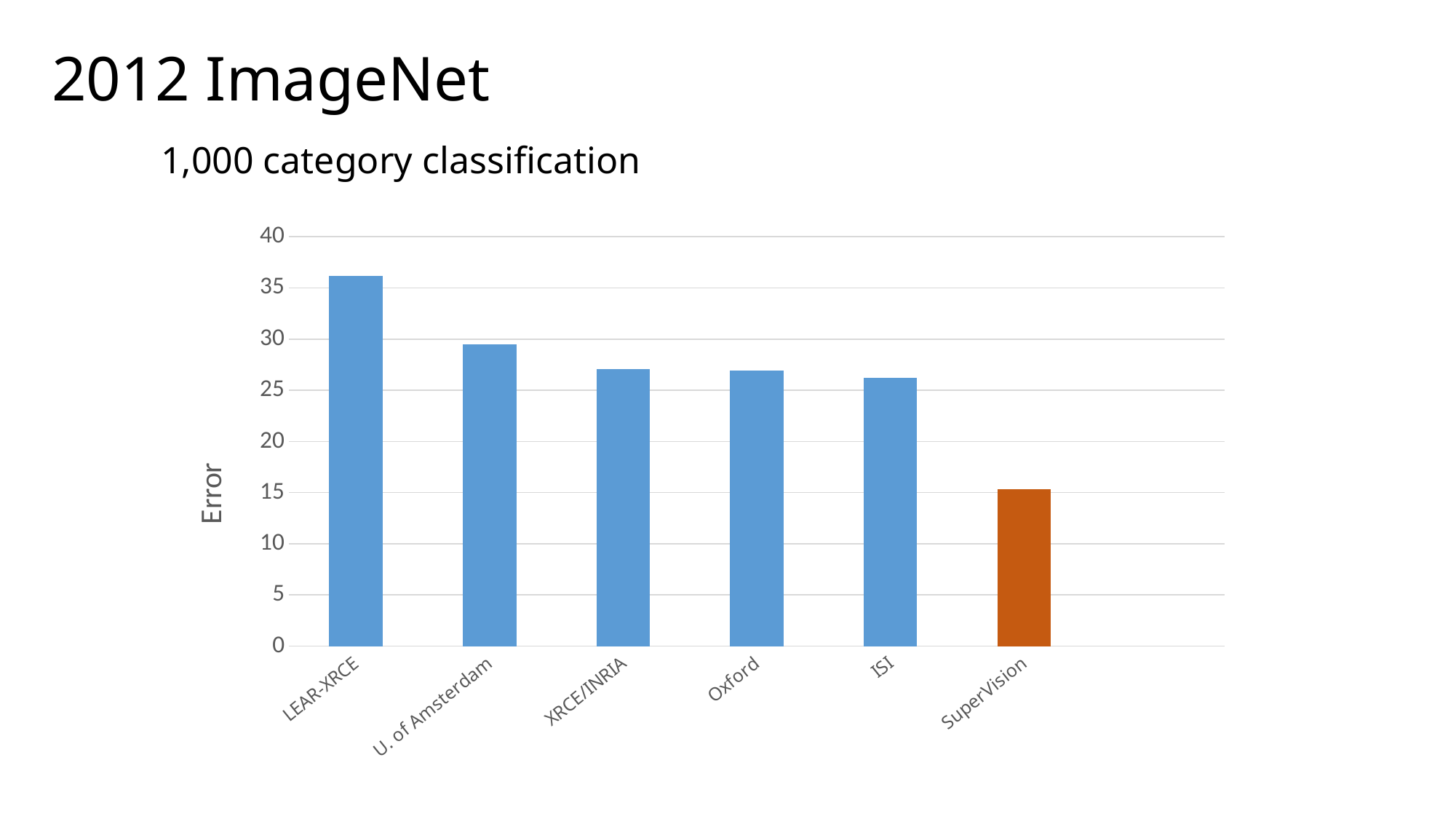
Which team has the highest error on the chart? LEAR-XRCE Which has the larger error, Oxford or SuperVision? Oxford Is the error for ISI greater or less than 25? greater How many categories (teams) are plotted on the chart? 6 Is the error for U. of Amsterdam greater or less than 30? less Which team has the lowest error on the chart? SuperVision What is the label on the vertical axis of the chart? Error Is the error for LEAR-XRCE greater or less than 35? greater Which has the larger error, U. of Amsterdam or ISI? U. of Amsterdam Do the error values generally rise or fall moving from left to right along the x axis? fall What kind of chart is shown on the slide? bar chart